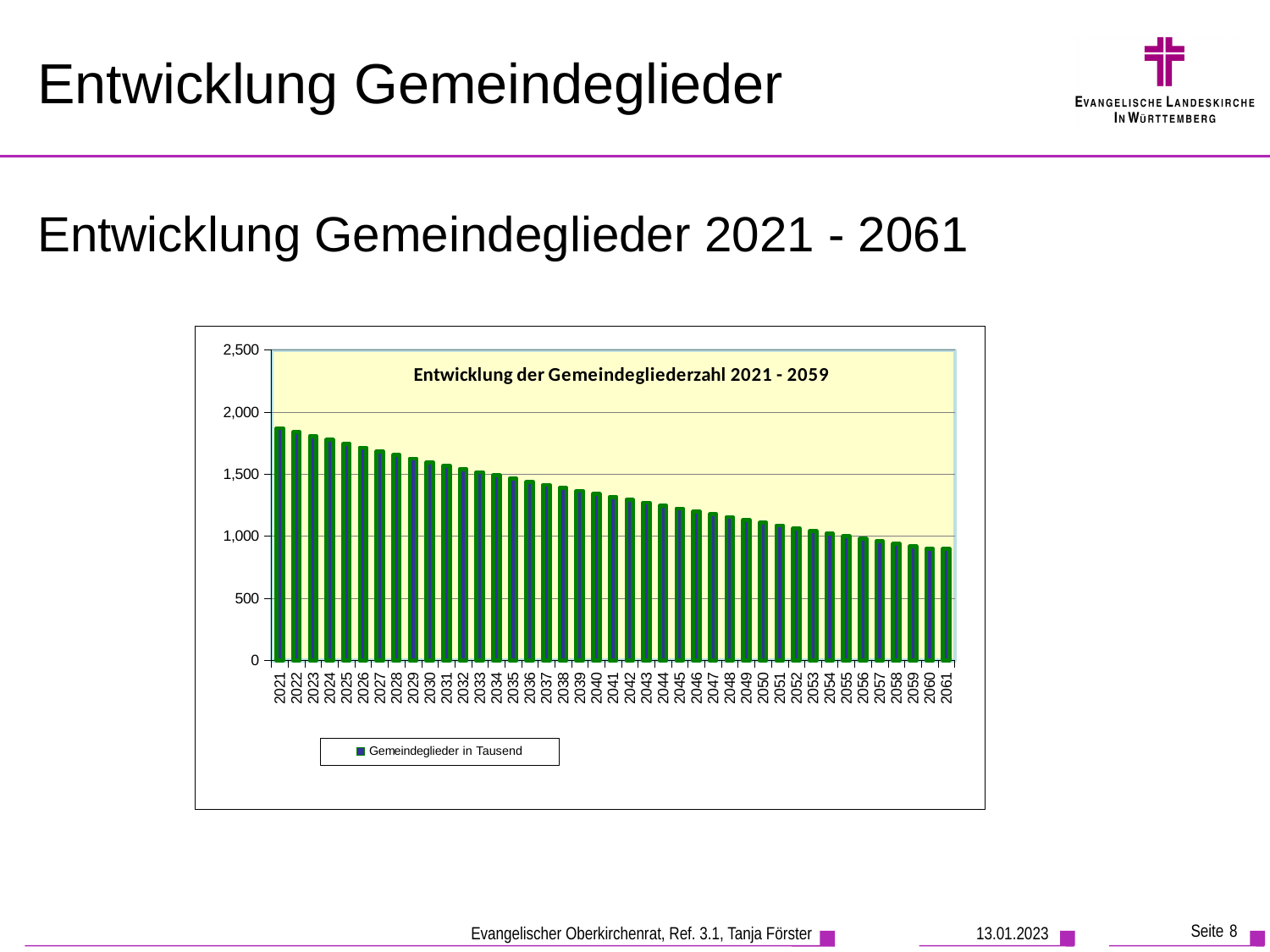
What kind of chart is shown on the slide? bar chart Is the value for 2021 greater or less than 1,500? greater Which year has the lowest value in the chart? 2060 and 2061 (tied) Do the values rise or fall from 2021 to 2061? fall What is the legend entry of the series shown in the chart? Gemeindeglieder in Tausend Which year has the highest value in the chart? 2021 Is the value for 2045 greater or less than 1,500? less Is the value for 2061 greater or less than 1,000? less How many years (bars) are plotted in the chart? 41 Which year has the larger value, 2025 or 2045? 2025 How many series does the legend list? 1